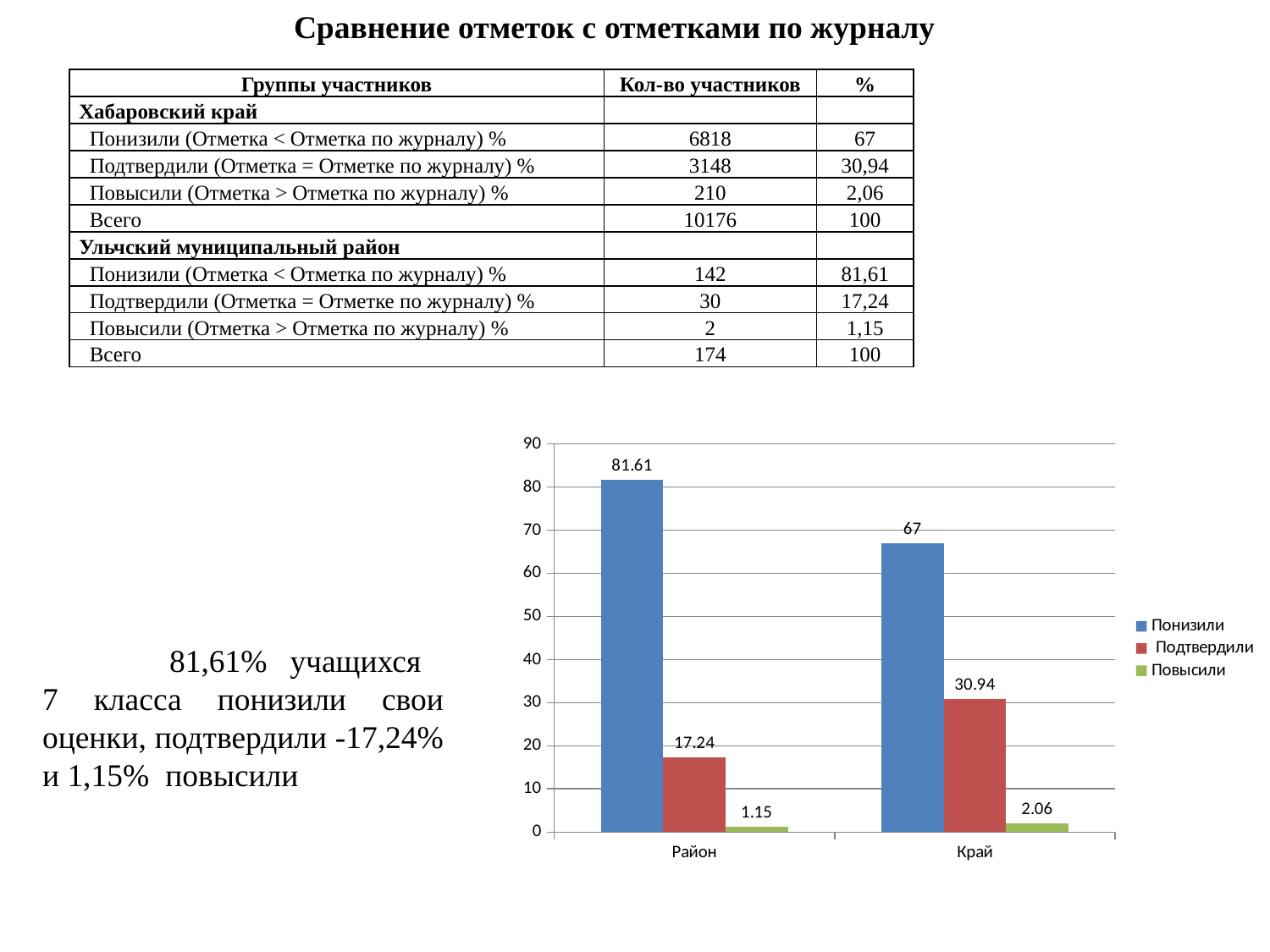
What is the value of the Понизили bar for Район? 81.61 Which category has the highest Понизили value? Район Which series has the lowest value for Край? Повысили What colour are the Подтвердили bars? Red What is the value of the Повысили bar for Район? 1.15 How many series does the legend list? 3 What is the value of the Подтвердили bar for Край? 30.94 Which is larger: the Подтвердили value for Район or for Край? Край What kind of chart is shown on the slide? Bar chart What is the difference between the Понизили values for Район and Край? 14.61 What is the value of the Понизили bar for Край? 67 How many categories are shown on the x axis? 2